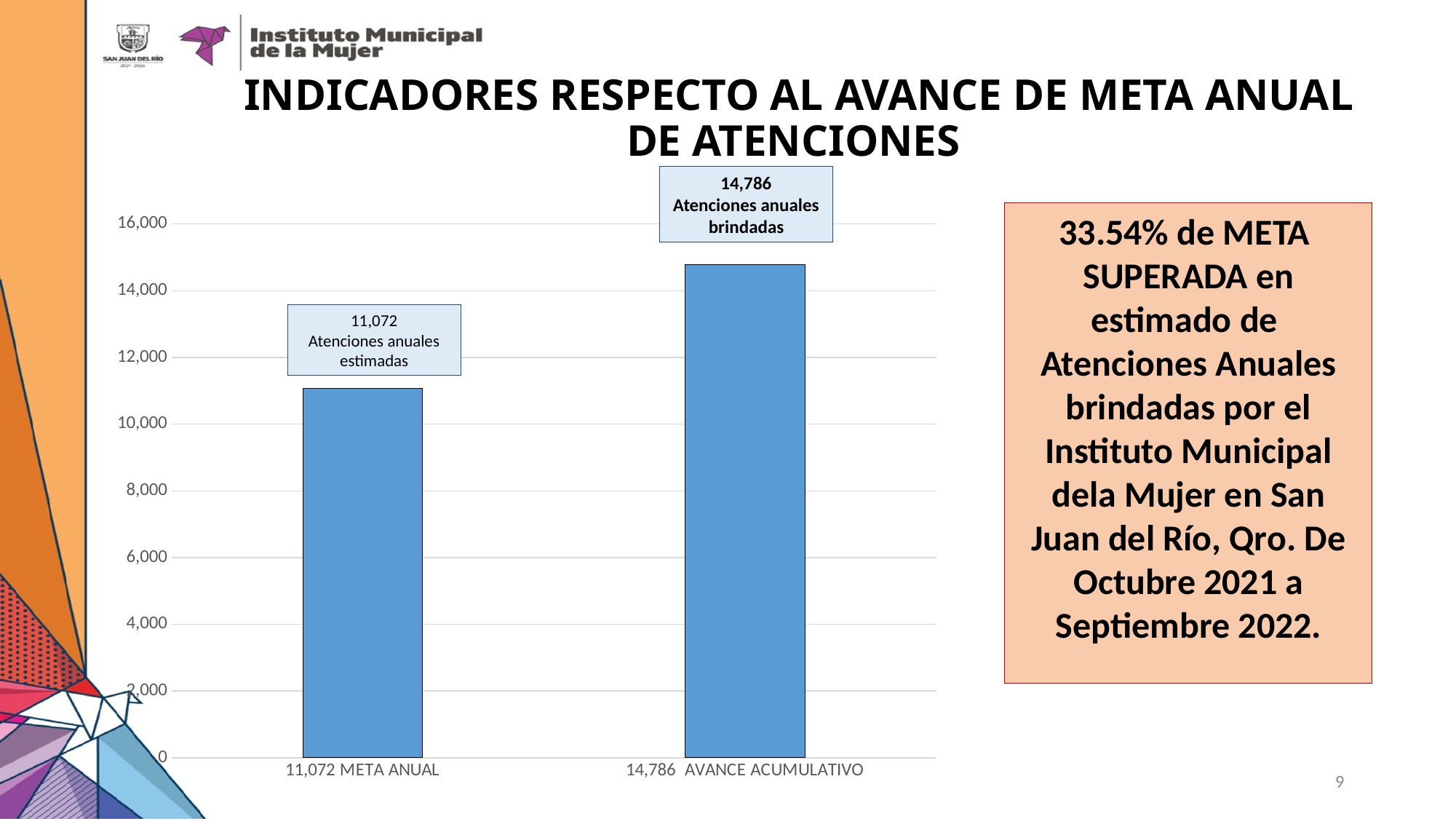
What is the value for META ANUAL? 11,072 Which is larger, META ANUAL or AVANCE ACUMULATIVO? AVANCE ACUMULATIVO What percentage of the goal was exceeded according to the text box on the slide? 33.54% How many bars are shown in the chart? 2 Which category has the lowest value? META ANUAL What is the highest value shown on the vertical axis? 16,000 What is the difference between AVANCE ACUMULATIVO and META ANUAL? 3,714 Is the value for AVANCE ACUMULATIVO greater or less than 14,000? greater Which category has the highest value? AVANCE ACUMULATIVO What kind of chart is shown on the slide? Bar chart What is the value for AVANCE ACUMULATIVO? 14,786 Is the value for META ANUAL greater or less than 12,000? less